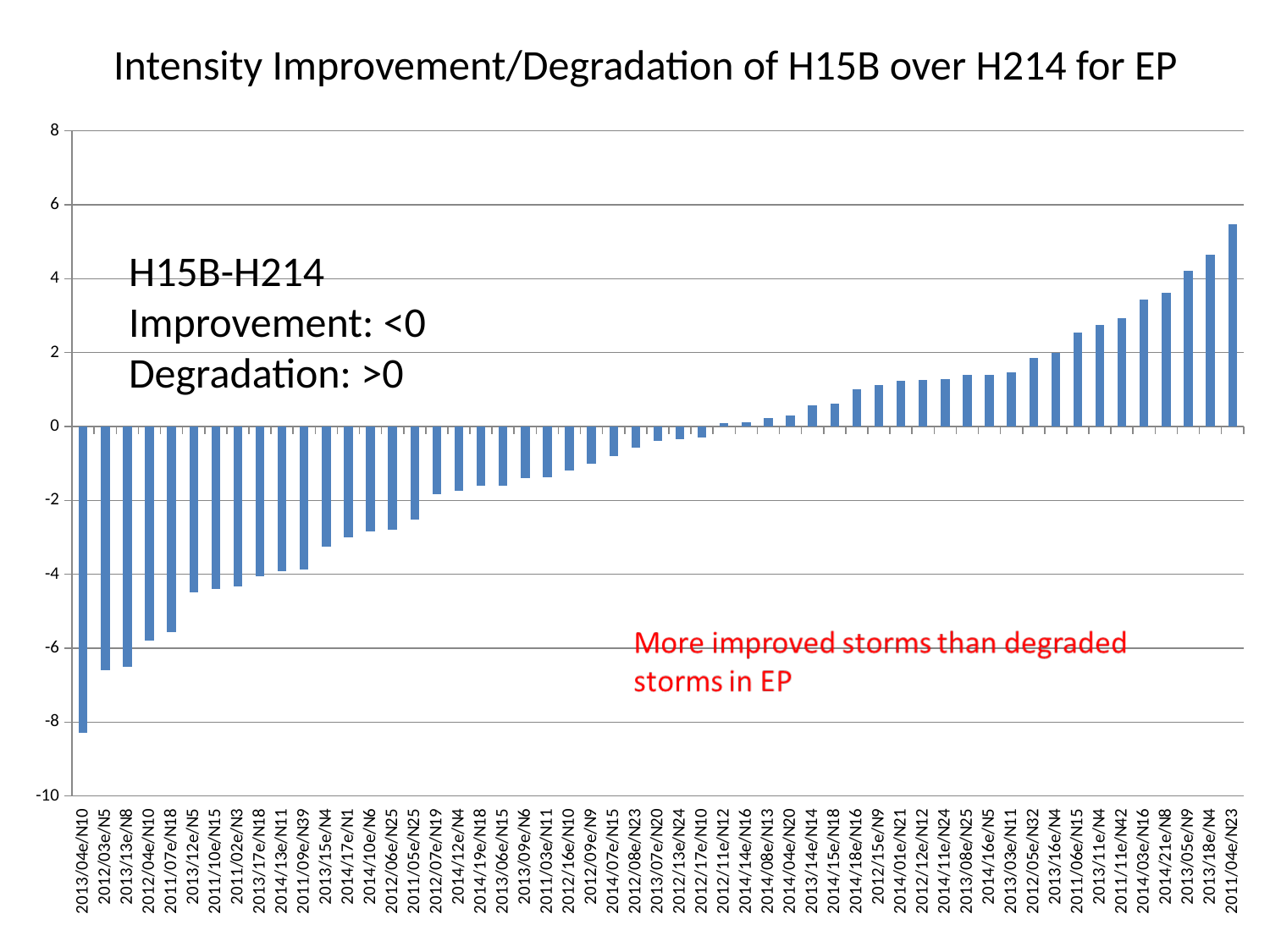
Which has the lower value, 2013/04e/N10 or 2012/03e/N5? 2013/04e/N10 Which category has the lowest value? 2013/04e/N10 Is the value for 2012/03e/N5 greater or less than -6? less What kind of chart is shown on the slide? bar chart Is the value for 2013/04e/N10 greater or less than -8? less What is the title of the chart? Intensity Improvement/Degradation of H15B over H214 for EP According to the red annotation on the chart, are there more improved or more degraded storms in EP? more improved storms Which category has the highest value? 2011/04e/N23 Is the value for 2013/18e/N4 greater or less than 4? greater Do the values rise or fall moving from left to right along the x axis? rise